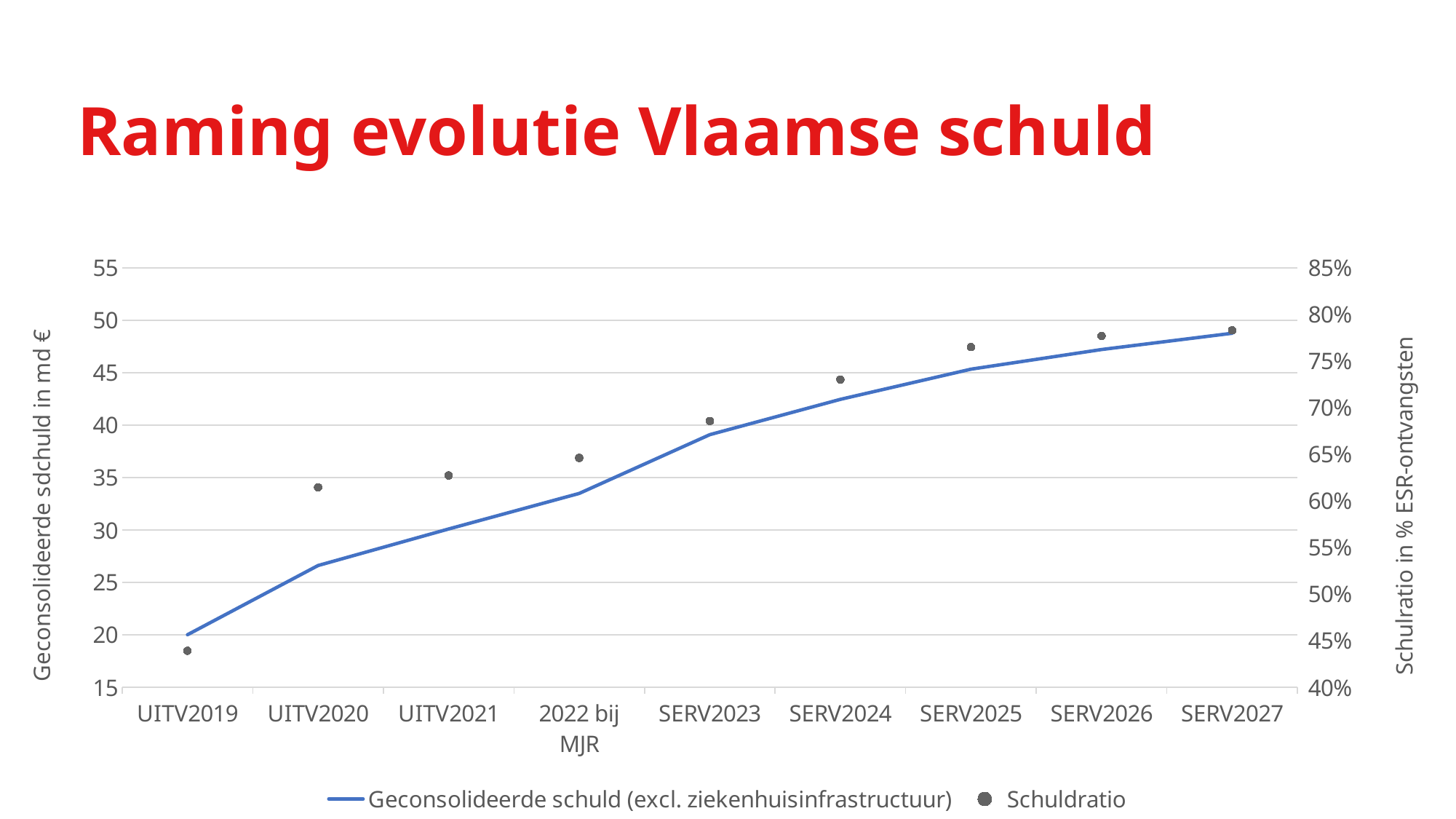
Which is larger, the Schuldratio for SERV2023 or for UITV2021? SERV2023 How many series does the legend list? 2 Which category has the highest Geconsolideerde schuld value? SERV2027 Is the Geconsolideerde schuld value for SERV2024 greater or less than 40? greater Which category has the lowest Schuldratio value? UITV2019 How many categories are shown on the x axis? 9 What is the title of the slide? Raming evolutie Vlaamse schuld What kind of chart is shown on the slide? line chart Is the Geconsolideerde schuld value for UITV2020 greater or less than 30? less Does the Geconsolideerde schuld line rise or fall from UITV2019 to SERV2027? rise Which series is drawn as a blue line? Geconsolideerde schuld (excl. ziekenhuisinfrastructuur) Is the Schuldratio value for UITV2019 greater or less than 50%? less